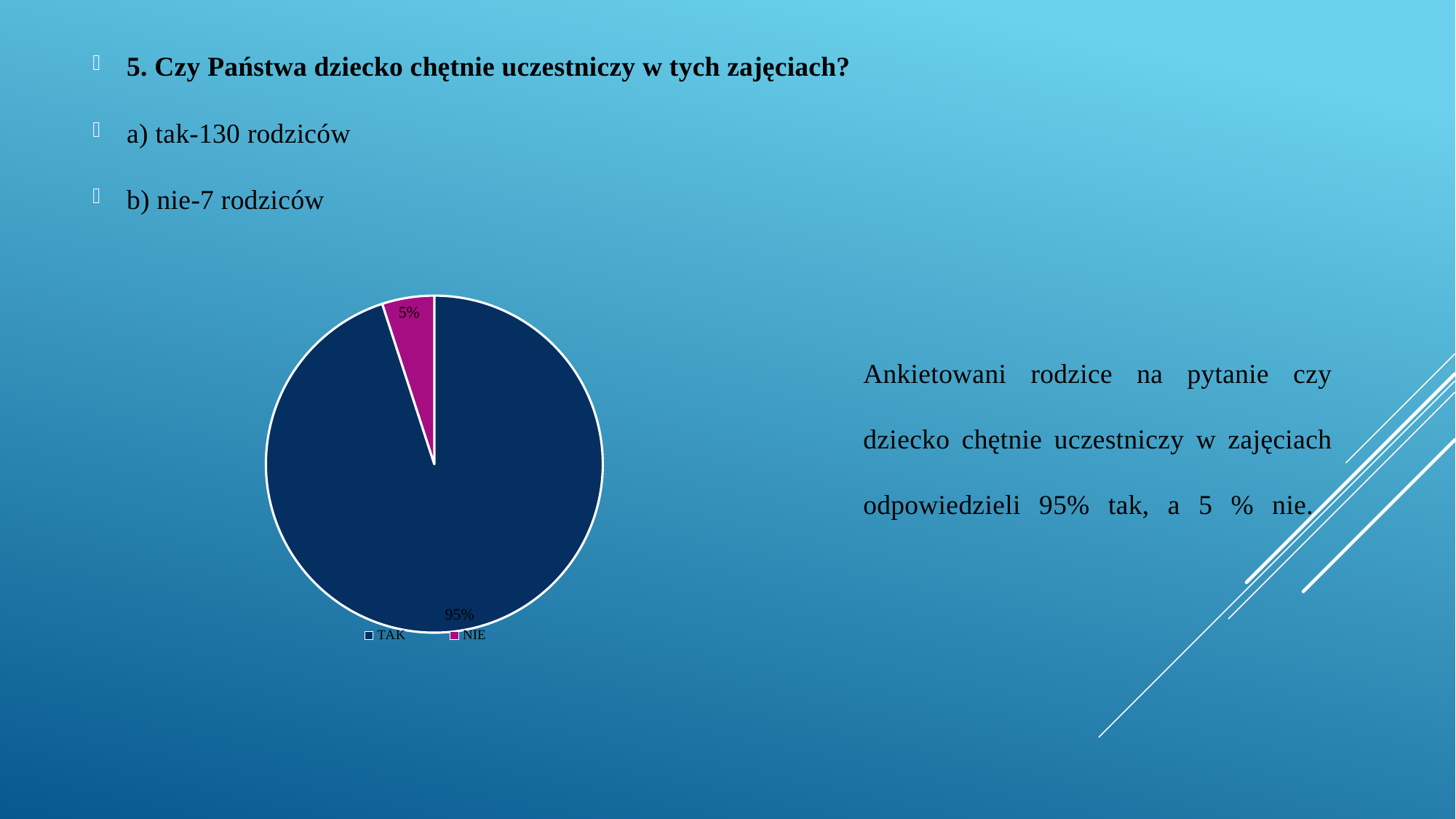
Which slice of the pie chart is the smallest? NIE Which slice is larger, TAK or NIE? TAK What colour is the TAK slice in the pie chart? dark blue How many slices does the pie chart have? 2 What percentage of the pie chart is labelled for TAK? 95% What percentage of the pie chart is labelled for NIE? 5% Which slice of the pie chart is the largest? TAK What colour is the NIE slice in the pie chart? magenta How many entries does the legend of the pie chart list? 2 What is the difference in percentage points between the TAK and NIE slices? 90 What kind of chart is shown on the slide? pie chart